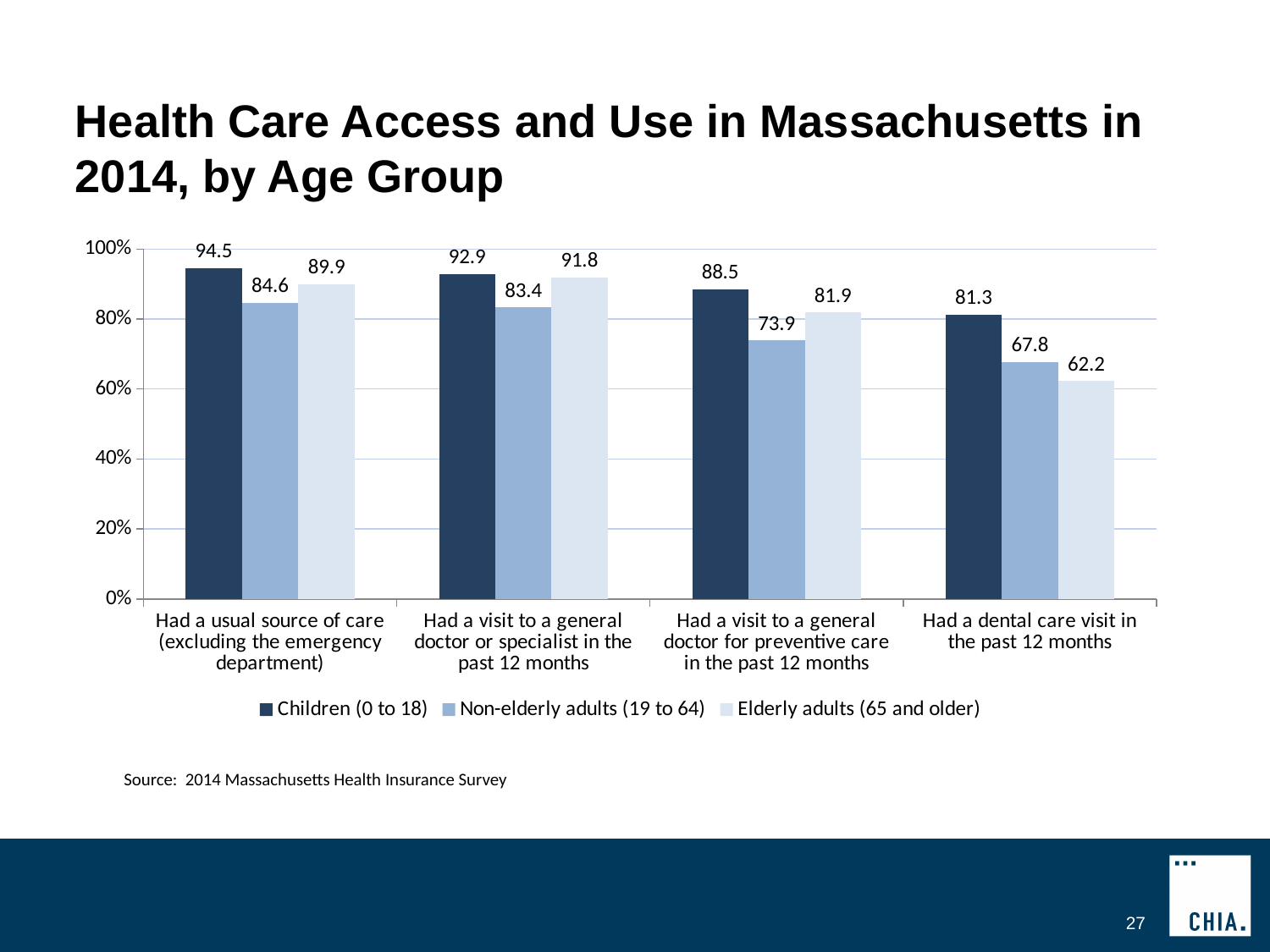
What is the value for Non-elderly adults (19 to 64) for 'Had a visit to a general doctor for preventive care in the past 12 months'? 73.9 What is the value for Elderly adults (65 and older) for 'Had a dental care visit in the past 12 months'? 62.2 Which is larger for 'Had a usual source of care (excluding the emergency department)': Non-elderly adults (19 to 64) or Elderly adults (65 and older)? Elderly adults (65 and older) Which age group has the lowest value for 'Had a dental care visit in the past 12 months'? Elderly adults (65 and older) Which age group has the highest value for 'Had a visit to a general doctor or specialist in the past 12 months'? Children (0 to 18) What kind of chart is shown on the slide? Bar chart How many categories are shown on the x axis? 4 How many series does the legend list? 3 Do the values for Children (0 to 18) rise or fall across the categories from left to right? Fall Is the value for Non-elderly adults (19 to 64) for 'Had a dental care visit in the past 12 months' greater or less than 80%? less What is the difference between the Children (0 to 18) and Non-elderly adults (19 to 64) values for 'Had a dental care visit in the past 12 months'? 13.5 What is the value for Children (0 to 18) for 'Had a usual source of care (excluding the emergency department)'? 94.5